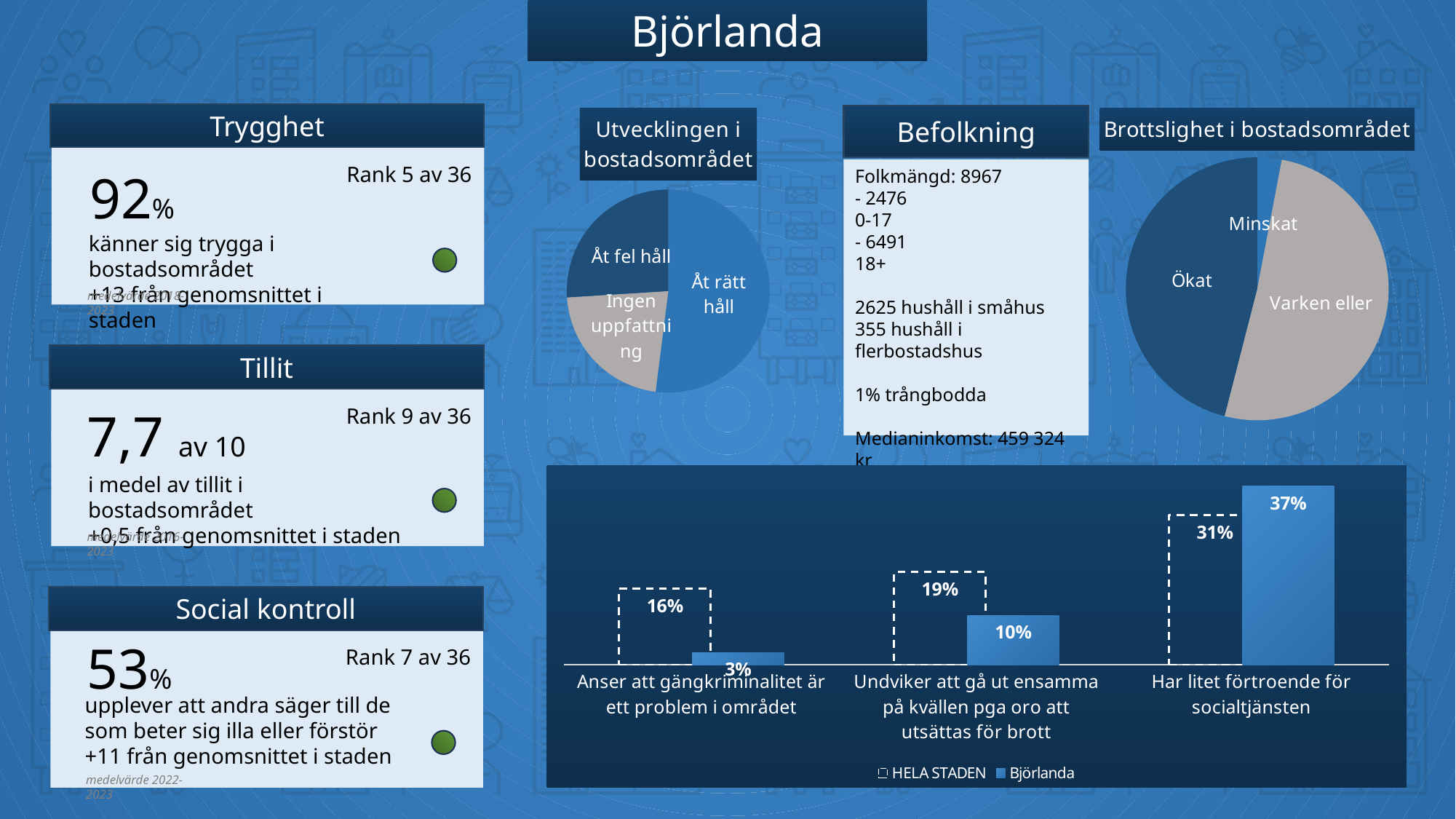
In the bar chart at the bottom, how many series does the legend list? 2 In the bar chart at the bottom, which is larger for 'Har litet förtroende för socialtjänsten': HELA STADEN or Björlanda? Björlanda In the bar chart at the bottom, what is the difference between the HELA STADEN and Björlanda values for 'Undviker att gå ut ensamma på kvällen pga oro att utsättas för brott'? 9% In the bar chart at the bottom, what is the Björlanda value for 'Undviker att gå ut ensamma på kvällen pga oro att utsättas för brott'? 10% In the bar chart at the bottom, which category has the highest Björlanda value? Har litet förtroende för socialtjänsten In the pie chart 'Brottslighet i bostadsområdet', which slice is the smallest? Minskat In the bar chart at the bottom, how many categories are shown on the x axis? 3 In the pie chart 'Utvecklingen i bostadsområdet', which slice is the largest? Åt rätt håll In the bar chart at the bottom, what is the HELA STADEN value for 'Anser att gängkriminalitet är ett problem i området'? 16% What kind of chart is 'Utvecklingen i bostadsområdet'? Pie chart In the bar chart at the bottom, what is the Björlanda value for 'Har litet förtroende för socialtjänsten'? 37% In the bar chart at the bottom, which category has the lowest Björlanda value? Anser att gängkriminalitet är ett problem i området